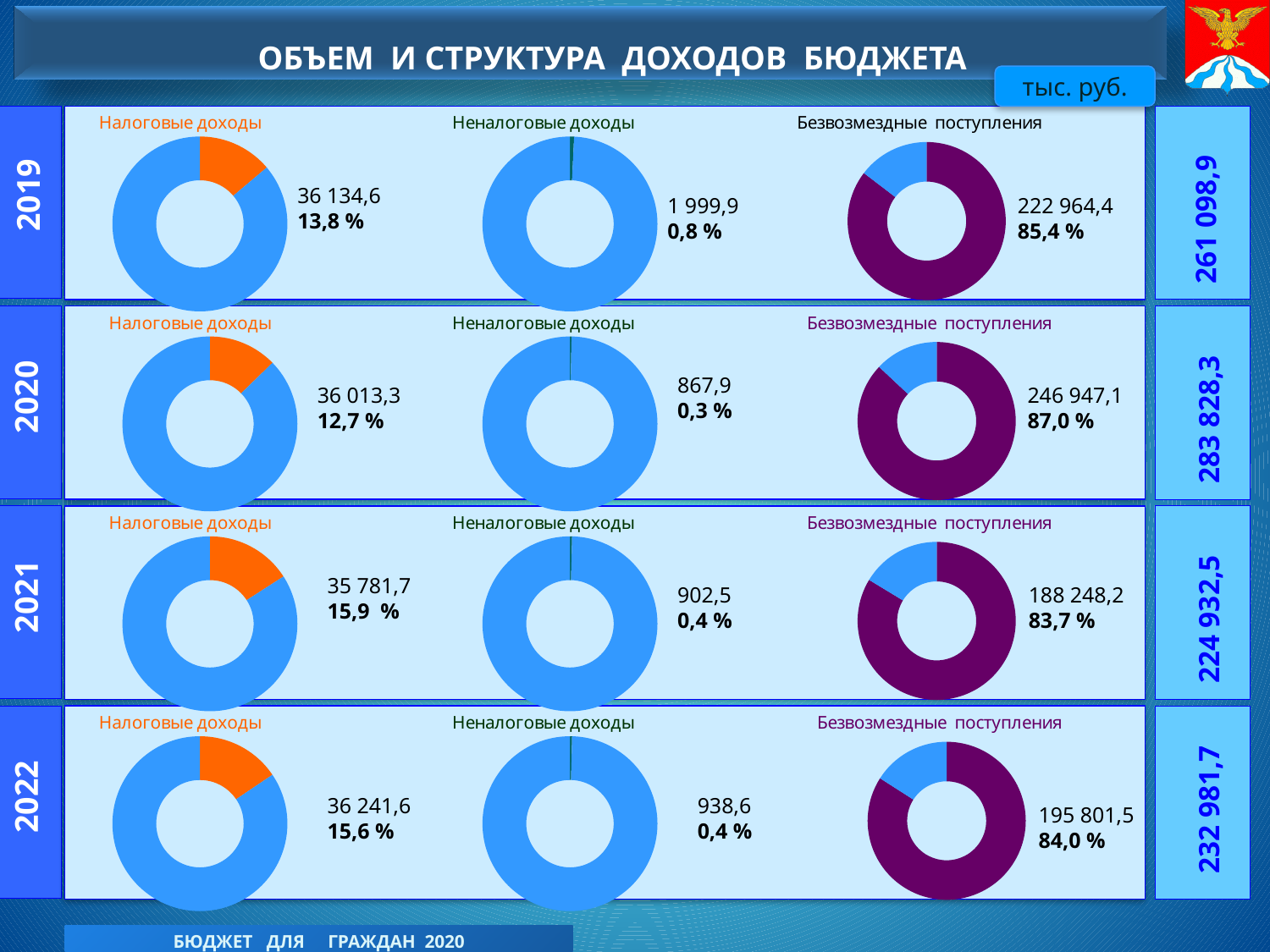
Across the four 'Безвозмездные поступления' donut charts, which year shows the highest printed percentage? 2020 On the 2020 'Безвозмездные поступления' donut chart, what value is printed next to the chart? 246 947,1 On the 2020 'Неналоговые доходы' donut chart, what value is printed next to the chart? 867,9 Across the four 'Неналоговые доходы' donut charts, which year shows the lowest printed percentage? 2020 On the 2022 'Безвозмездные поступления' donut chart, what value is printed next to the chart? 195 801,5 What is the difference between the 'Неналоговые доходы' values for 2019 and 2020? 1 132,0 What kind of chart is used for each of the twelve charts on the slide? Donut (pie) chart What unit is shown in the box at the top right of the slide? тыс. руб. On the 2019 'Налоговые доходы' donut chart, what value is printed next to the chart? 36 134,6 On the 2019 'Безвозмездные поступления' donut chart, what share is printed for the highlighted segment? 85,4 % Which is larger: the 'Налоговые доходы' value for 2022 or for 2021? 2022 On the 2021 'Налоговые доходы' donut chart, what percentage is printed? 15,9 %